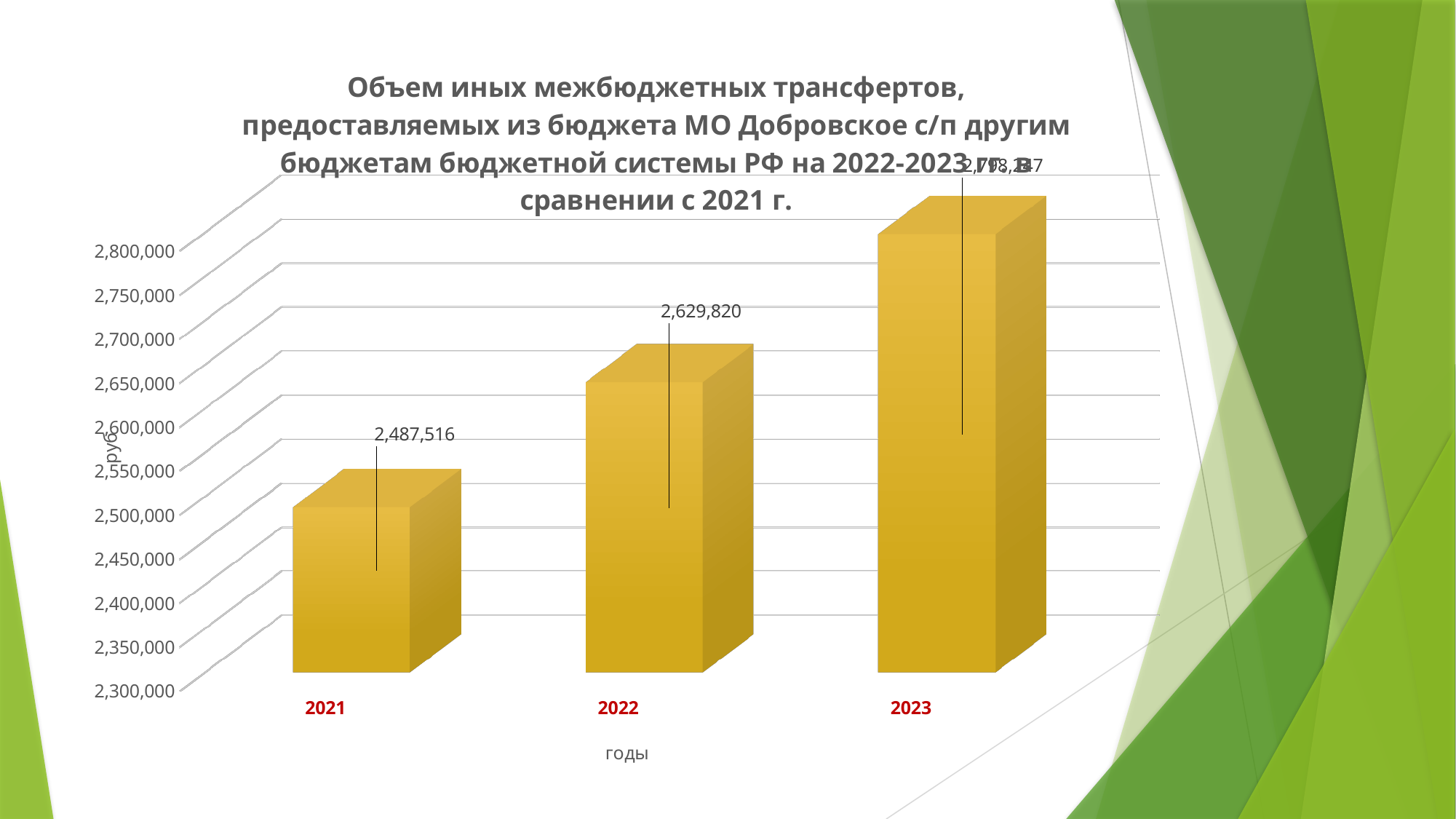
How many years are shown on the x axis? 3 What is the difference between the values for 2022 and 2021? 142,304 Is the value for 2023 greater or less than 2,750,000? greater Is the value for 2021 greater or less than 2,500,000? less What is the label of the x axis? годы What is the value for 2021? 2,487,516 What kind of chart is shown on the slide? bar chart What is the value for 2022? 2,629,820 Which is larger, the value for 2022 or the value for 2021? 2022 Which year has the lowest value? 2021 Do the values rise or fall from 2021 to 2023? rise Which year has the highest value? 2023